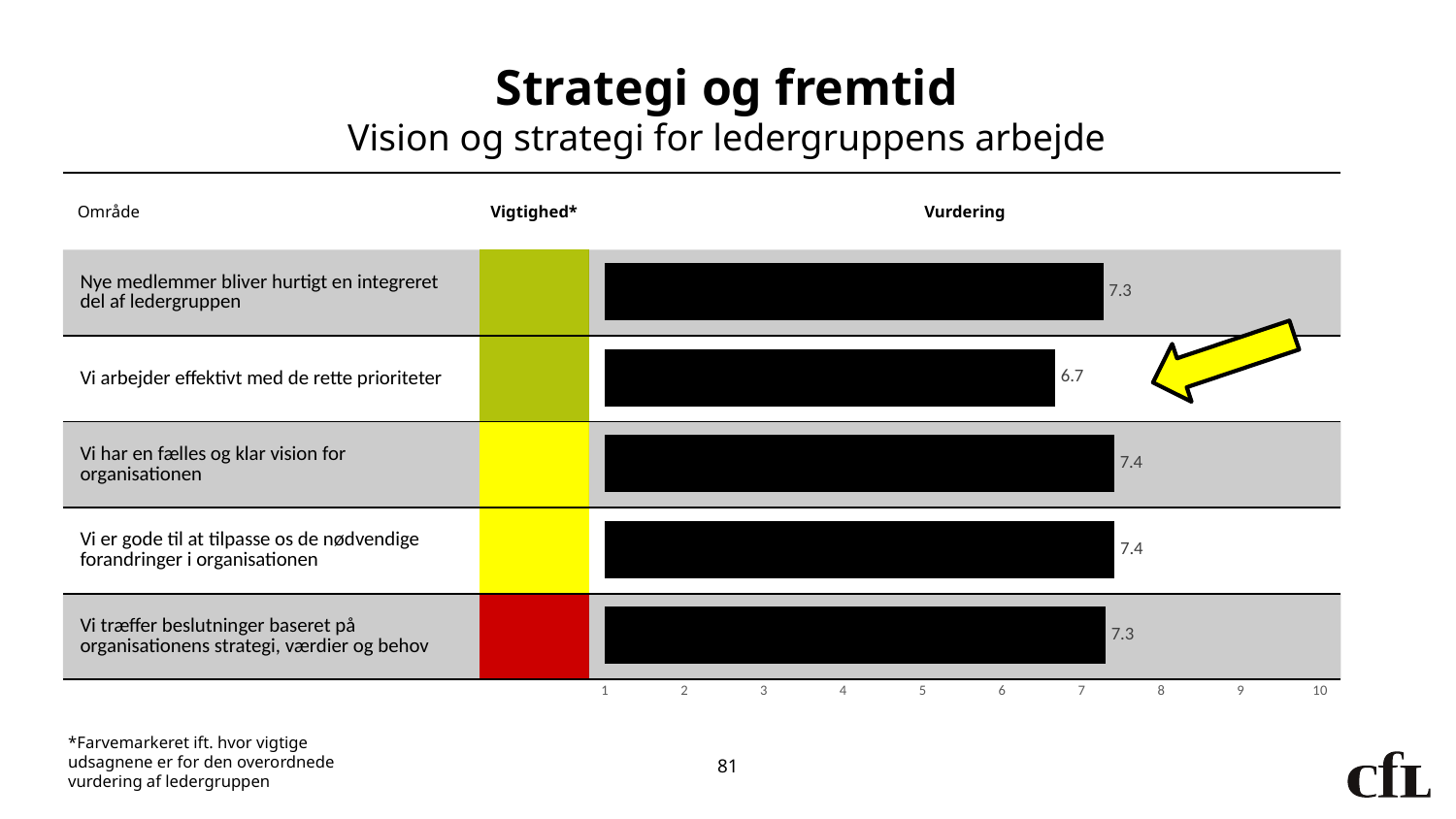
Which statement has the lowest Vurdering value? Vi arbejder effektivt med de rette prioriteter What is the Vurdering value for "Vi træffer beslutninger baseret på organisationens strategi, værdier og behov"? 7.3 How many statements (bars) are shown in the chart? 5 What is the highest value shown on the Vurdering axis? 10 What is the Vurdering value for "Vi arbejder effektivt med de rette prioriteter"? 6.7 What colour is the Vigtighed marker for "Vi træffer beslutninger baseret på organisationens strategi, værdier og behov"? red What kind of chart is used to show the Vurdering values? bar chart What is the Vurdering value for "Vi har en fælles og klar vision for organisationen"? 7.4 What is the difference between the Vurdering values for "Vi har en fælles og klar vision for organisationen" and "Vi arbejder effektivt med de rette prioriteter"? 0.7 Is the Vurdering value for "Vi arbejder effektivt med de rette prioriteter" greater or less than 7? less What is the Vurdering value for "Nye medlemmer bliver hurtigt en integreret del af ledergruppen"? 7.3 Which has a higher Vurdering value: "Vi er gode til at tilpasse os de nødvendige forandringer i organisationen" or "Vi arbejder effektivt med de rette prioriteter"? Vi er gode til at tilpasse os de nødvendige forandringer i organisationen